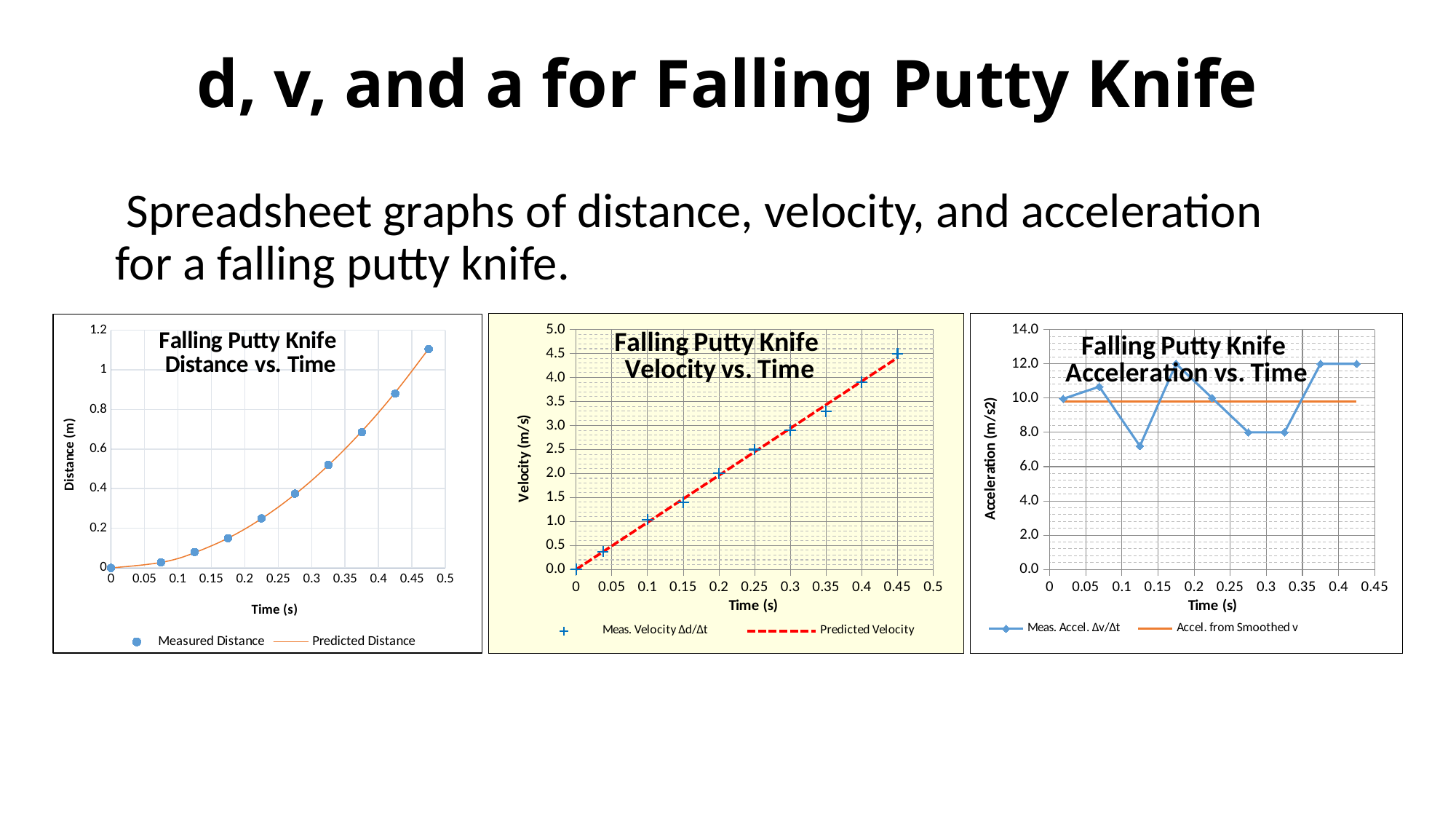
In the 'Falling Putty Knife Distance vs. Time' chart, is the measured distance at 0.475 s greater or less than 1? greater In the 'Falling Putty Knife Distance vs. Time' chart, do the measured distance values rise or fall as time increases? rise In the 'Falling Putty Knife Velocity vs. Time' chart, how many measured velocity points are plotted? 10 What kind of chart is the 'Falling Putty Knife Distance vs. Time' chart? scatter chart with a fitted line In the 'Falling Putty Knife Acceleration vs. Time' chart, at which time is the measured acceleration lowest? 0.125 In the 'Falling Putty Knife Velocity vs. Time' chart, do the velocity values rise or fall along the time axis? rise In the 'Falling Putty Knife Velocity vs. Time' chart, is the measured velocity at 0.4 s greater or less than 3.5? greater How many series does the legend of the 'Falling Putty Knife Distance vs. Time' chart list? 2 In the 'Falling Putty Knife Acceleration vs. Time' chart, which is larger: the measured acceleration at 0.175 s or at 0.275 s? 0.175 s In the 'Falling Putty Knife Acceleration vs. Time' chart, is the measured acceleration at 0.125 s greater or less than 8.0? less What are the two legend entries of the 'Falling Putty Knife Velocity vs. Time' chart? Meas. Velocity Δd/Δt and Predicted Velocity In the 'Falling Putty Knife Distance vs. Time' chart, how many measured distance points are plotted? 10